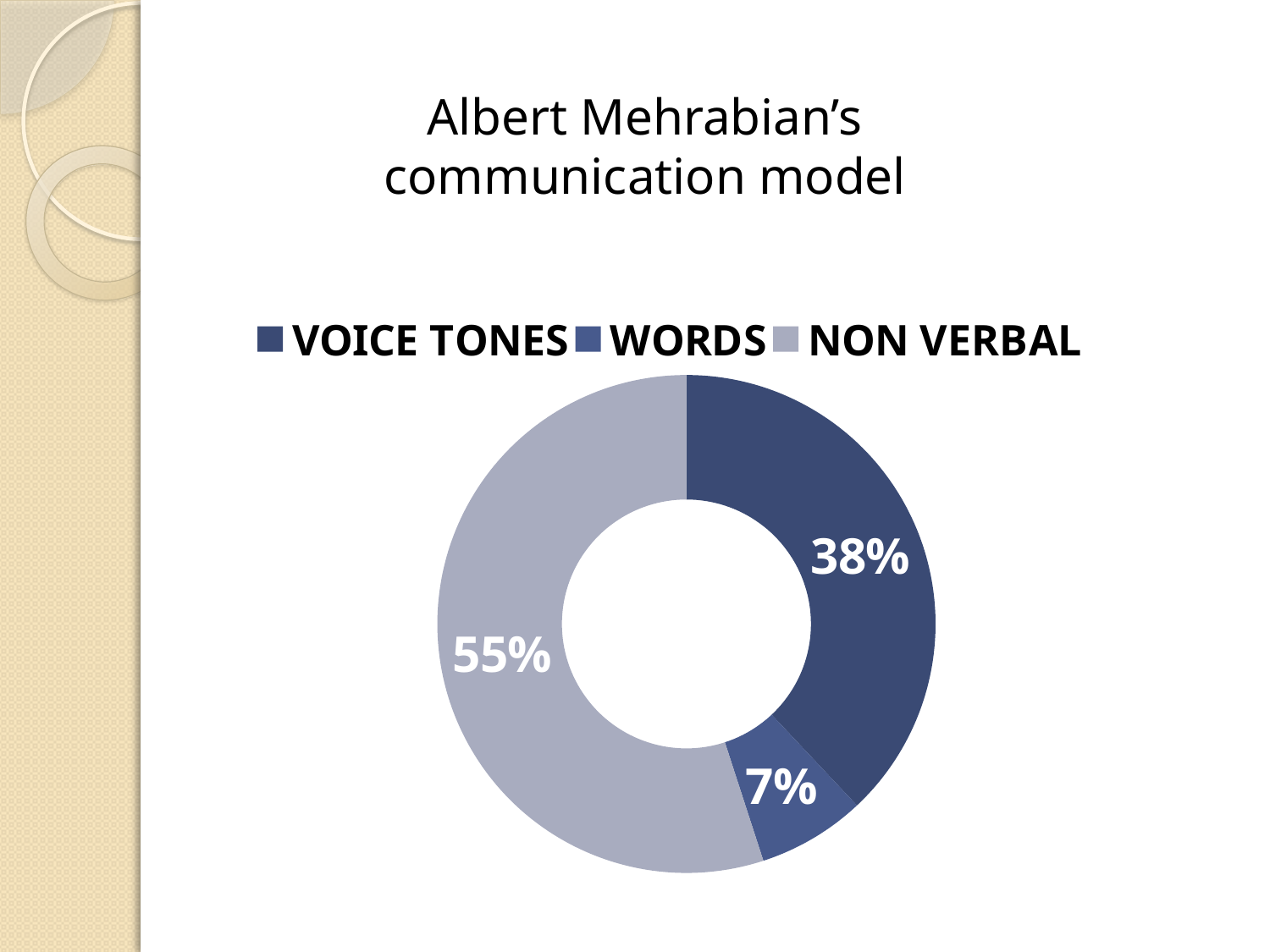
What percentage is shown for VOICE TONES? 38% What is the difference between the NON VERBAL and VOICE TONES percentages? 17% What is the difference between the VOICE TONES and WORDS percentages? 31% What percentage is shown for WORDS? 7% Which category is shown in the lightest colour in the legend? NON VERBAL What is the title of the slide containing the chart? Albert Mehrabian's communication model What percentage is shown for NON VERBAL? 55% Which category has the largest share of the chart? NON VERBAL Which is larger, VOICE TONES or WORDS? VOICE TONES What kind of chart is shown on the slide? Doughnut chart Which category has the smallest share of the chart? WORDS How many categories are shown in the chart? 3